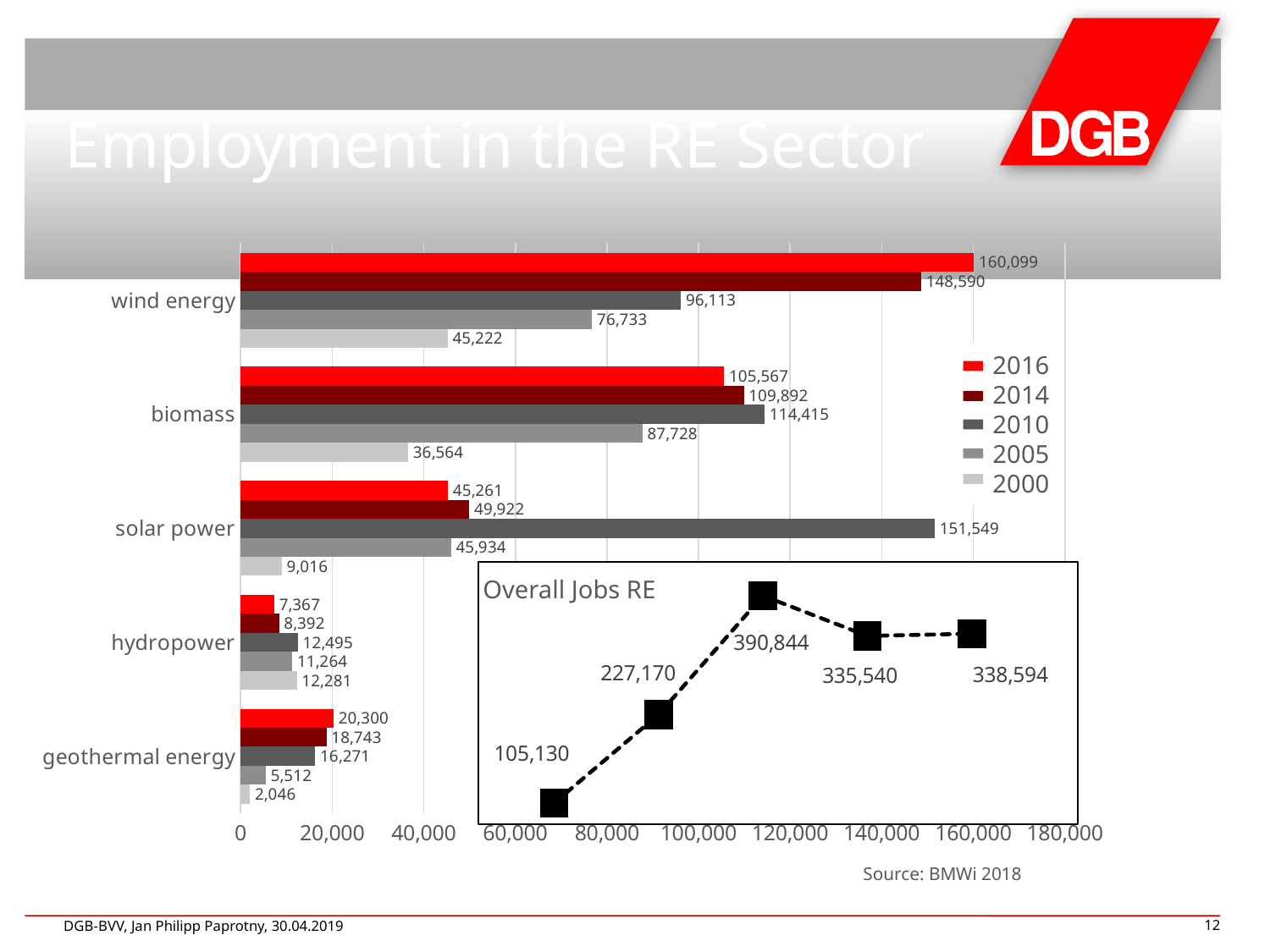
How many categories are shown on the bar chart? 5 How many series does the legend of the bar chart list? 5 In the 'Overall Jobs RE' chart, what is the difference between the first value and the last value? 233,464 In the bar chart, which category has the lowest value for 2014? hydropower In the bar chart, what is the value for geothermal energy in 2000? 2,046 In the bar chart, which category has the highest value for 2016? wind energy What kind of chart is the inset chart titled 'Overall Jobs RE'? line chart In the bar chart, which is larger for biomass: the 2010 value or the 2016 value? 2010 In the bar chart, what is the value for wind energy in 2016? 160,099 In the bar chart, what is the value for solar power in 2010? 151,549 In the bar chart, what is the difference between the 2016 and 2000 values for wind energy? 114,877 In the 'Overall Jobs RE' chart, what is the highest value shown? 390,844